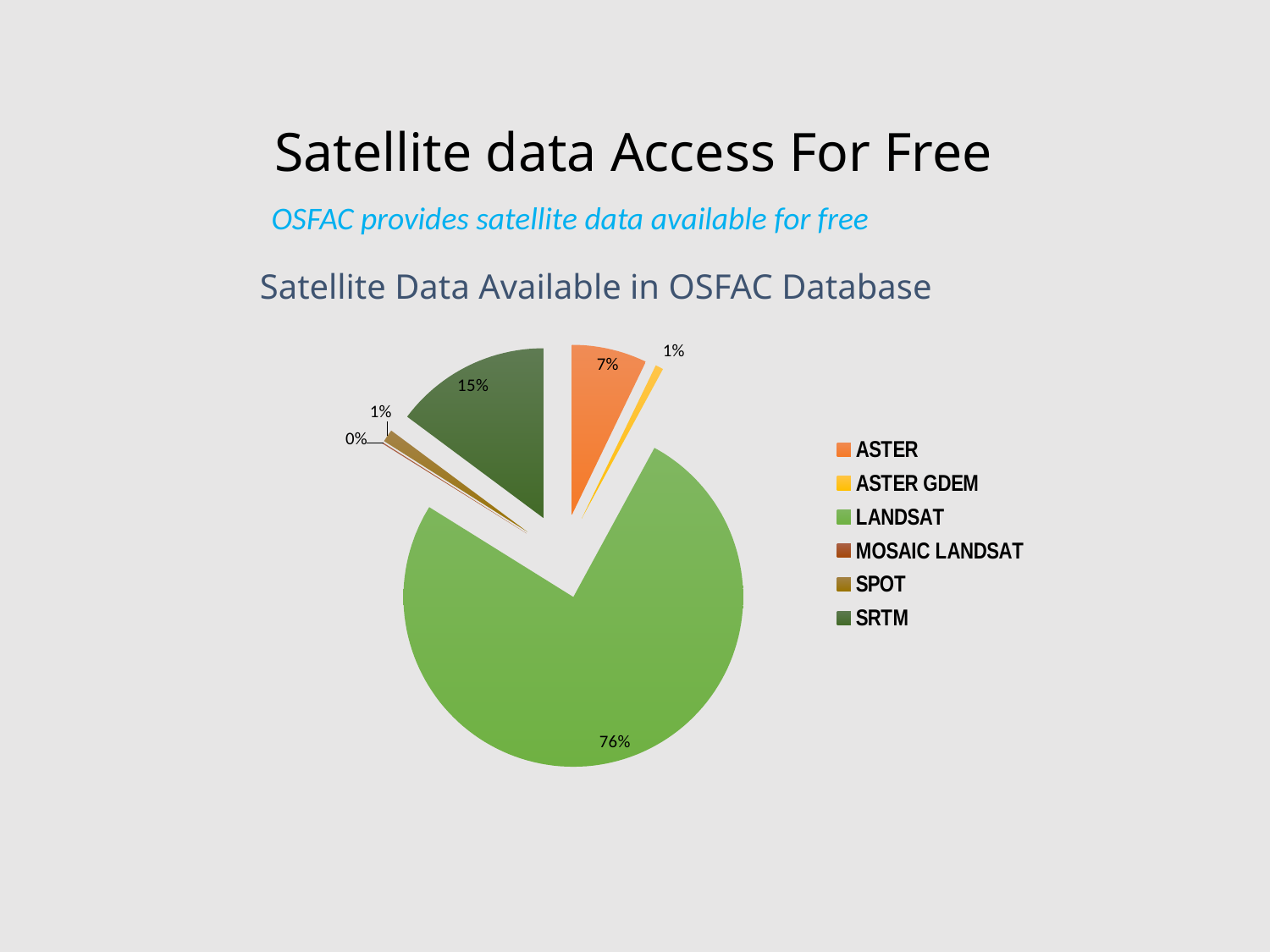
What share of the pie does SRTM account for? 15% What share of the pie does LANDSAT account for? 76% What is the title of the chart? Satellite Data Available in OSFAC Database How many categories does the legend list? 6 Which category has the smallest slice of the pie? MOSAIC LANDSAT What colour is the LANDSAT slice in the legend? green What kind of chart is shown on the slide? pie chart What is the difference in percentage points between the LANDSAT and SRTM slices? 61 Which category has the largest slice of the pie? LANDSAT Which is larger, the SRTM slice or the ASTER slice? SRTM What share of the pie does ASTER account for? 7%